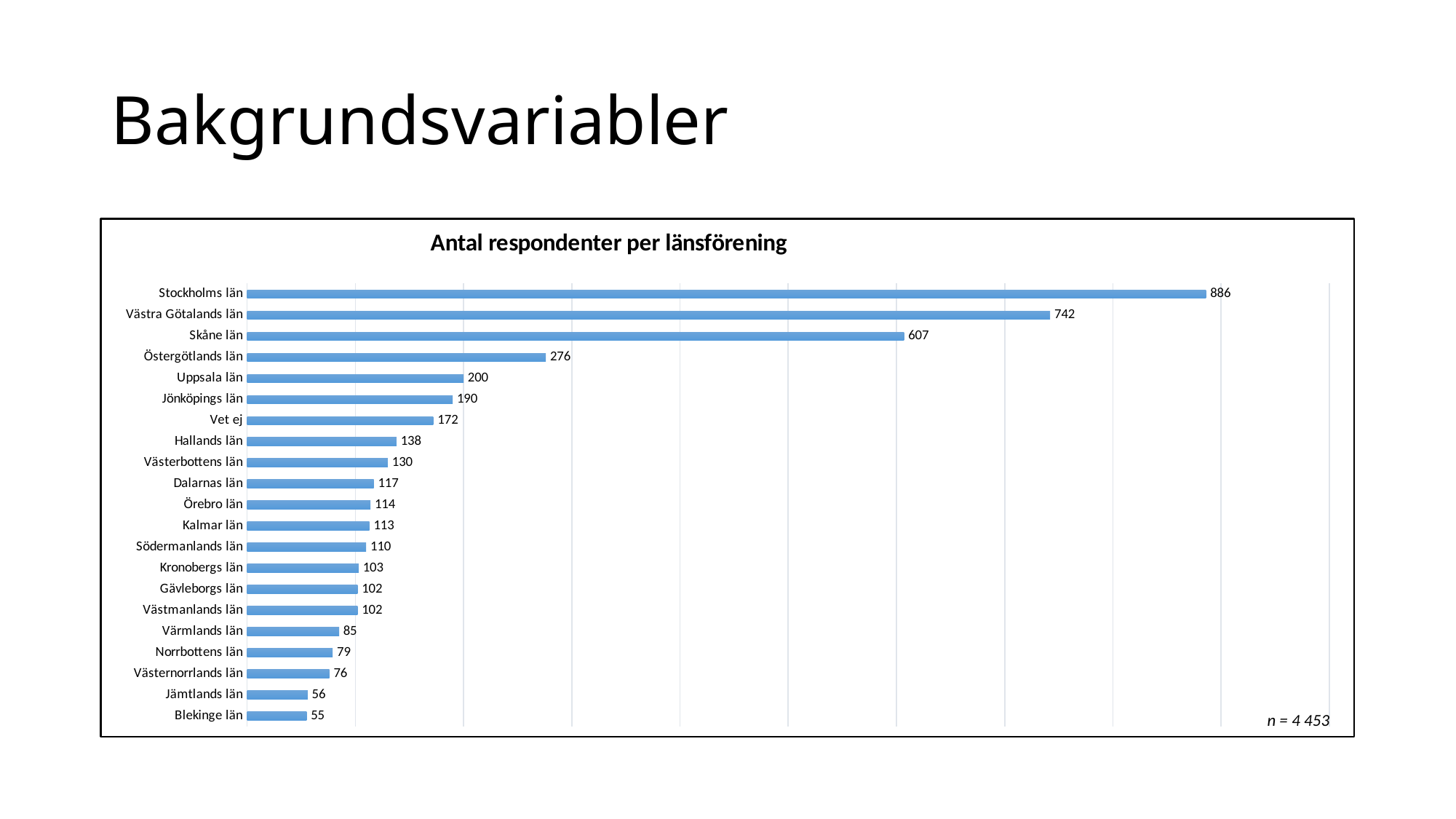
What is the title of the chart? Antal respondenter per länsförening What is the value for Skåne län? 607 What is the value for Vet ej? 172 What is the difference between the values for Stockholms län and Västra Götalands län? 144 How many categories are shown in the chart? 21 Which category has the highest value? Stockholms län What is the value for Västernorrlands län? 76 What is the difference between the values for Östergötlands län and Uppsala län? 76 Which category has the lowest value? Blekinge län Which is larger, the value for Hallands län or the value for Dalarnas län? Hallands län What is the value for Stockholms län? 886 What kind of chart is shown on the slide? Bar chart